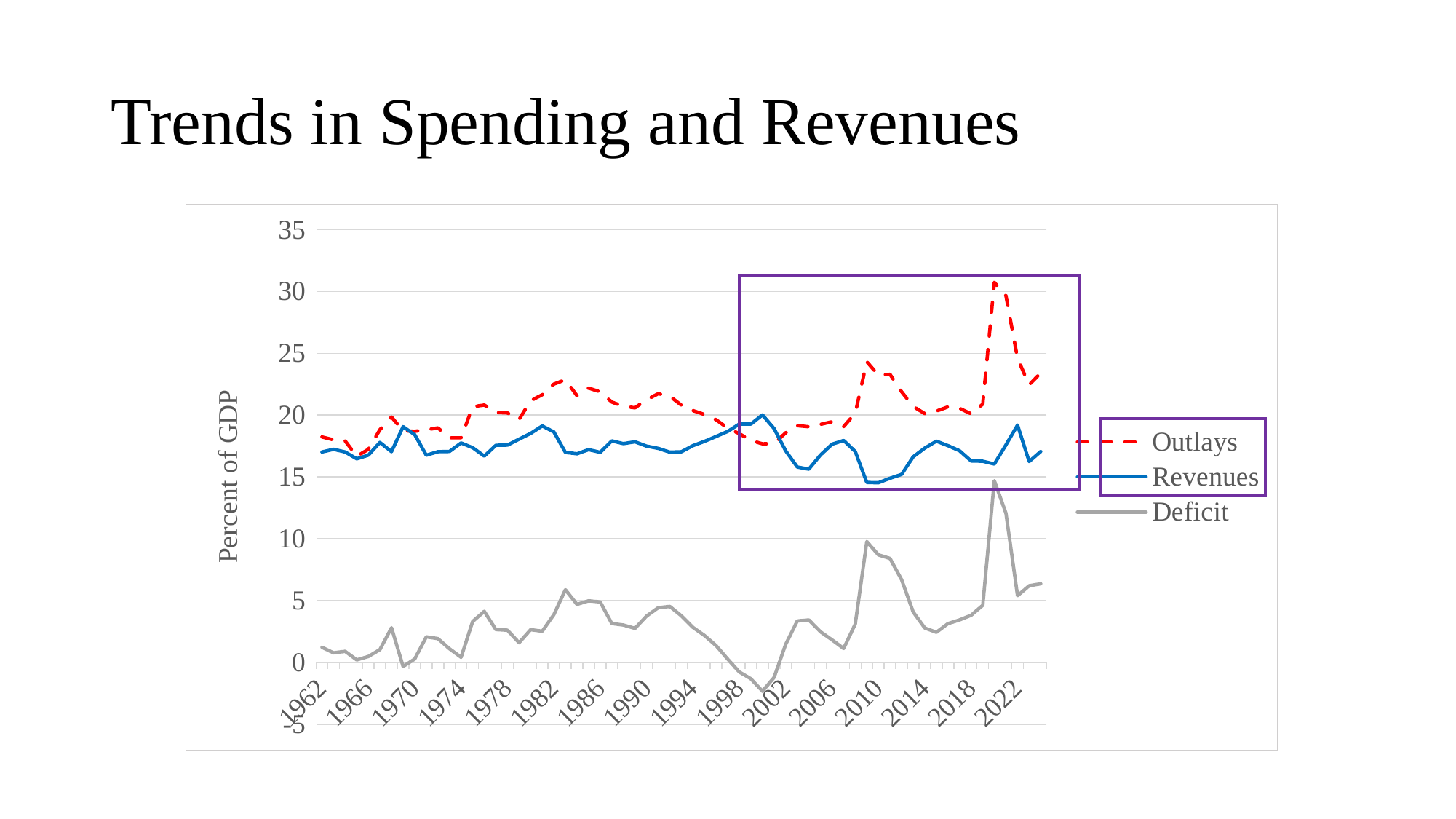
Is the value of Deficit in 1962 greater or less than 5? less Is the value of Deficit around 2020 greater or less than 10? greater What kind of chart is shown on the slide? line chart Which series reaches the highest value anywhere on the chart? Outlays Is the peak value of Outlays around 2020 greater or less than 25? greater What is the label on the vertical axis? Percent of GDP How many series does the legend list? 3 Do Outlays rise or fall between 2018 and 2020? rise Is the Deficit higher around 2020 or around 2010? around 2020 In 2022, which is higher, Outlays or Revenues? Outlays Which series is drawn as a red dashed line? Outlays